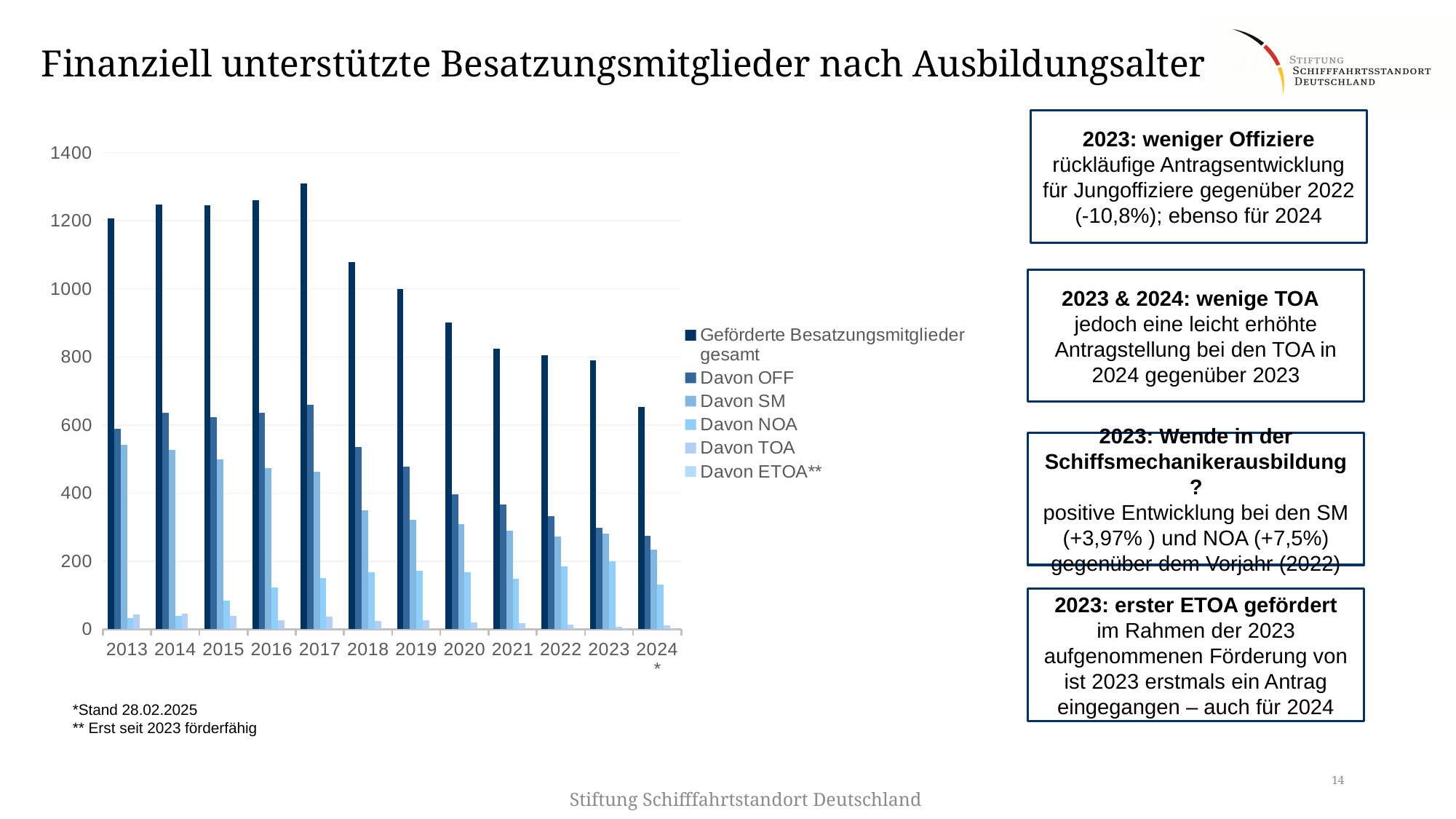
How many series does the legend list? 6 Is the value for 'Davon NOA' in 2016 greater or less than 100? greater Which is larger in 2017: the value for 'Davon OFF' or the value for 'Davon SM'? Davon OFF Is the value for 'Davon OFF' in 2017 greater or less than 600? greater Is the value for 'Geförderte Besatzungsmitglieder gesamt' in 2024 greater or less than 800? less How many years are shown on the x axis? 12 Do the values for 'Geförderte Besatzungsmitglieder gesamt' rise or fall from 2017 to 2024? fall What kind of chart is shown on the slide? bar chart In which year is the value for 'Geförderte Besatzungsmitglieder gesamt' highest? 2017 In which year is the value for 'Geförderte Besatzungsmitglieder gesamt' lowest? 2024 Which legend entry is marked with two asterisks? Davon ETOA**